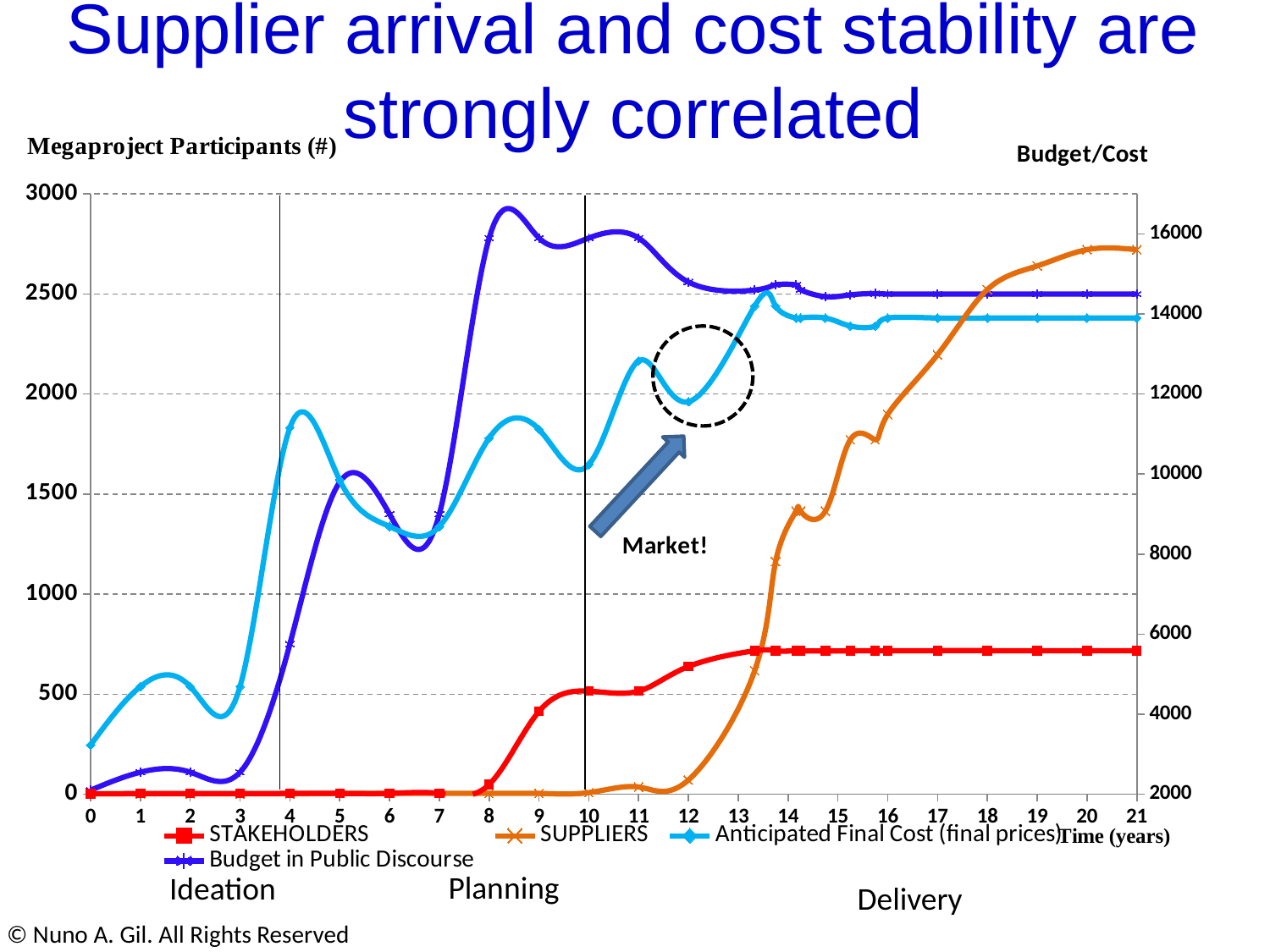
At year 21, which is plotted higher on the chart: SUPPLIERS or STAKEHOLDERS? SUPPLIERS What are the three phase labels written beneath the chart? Ideation, Planning, Delivery How many time points are shown along the x axis (years 0 to 21)? 22 Is the value of STAKEHOLDERS at year 21 greater or less than 1000? less What is the label of the left vertical axis? Megaproject Participants (#) What kind of chart is shown on the slide? line chart Is the value of SUPPLIERS at year 21 greater or less than 2500? greater Is the value of SUPPLIERS at year 12 greater or less than 500? less How many series does the legend list? 4 Does the SUPPLIERS line generally rise or fall from year 10 to year 21? rise